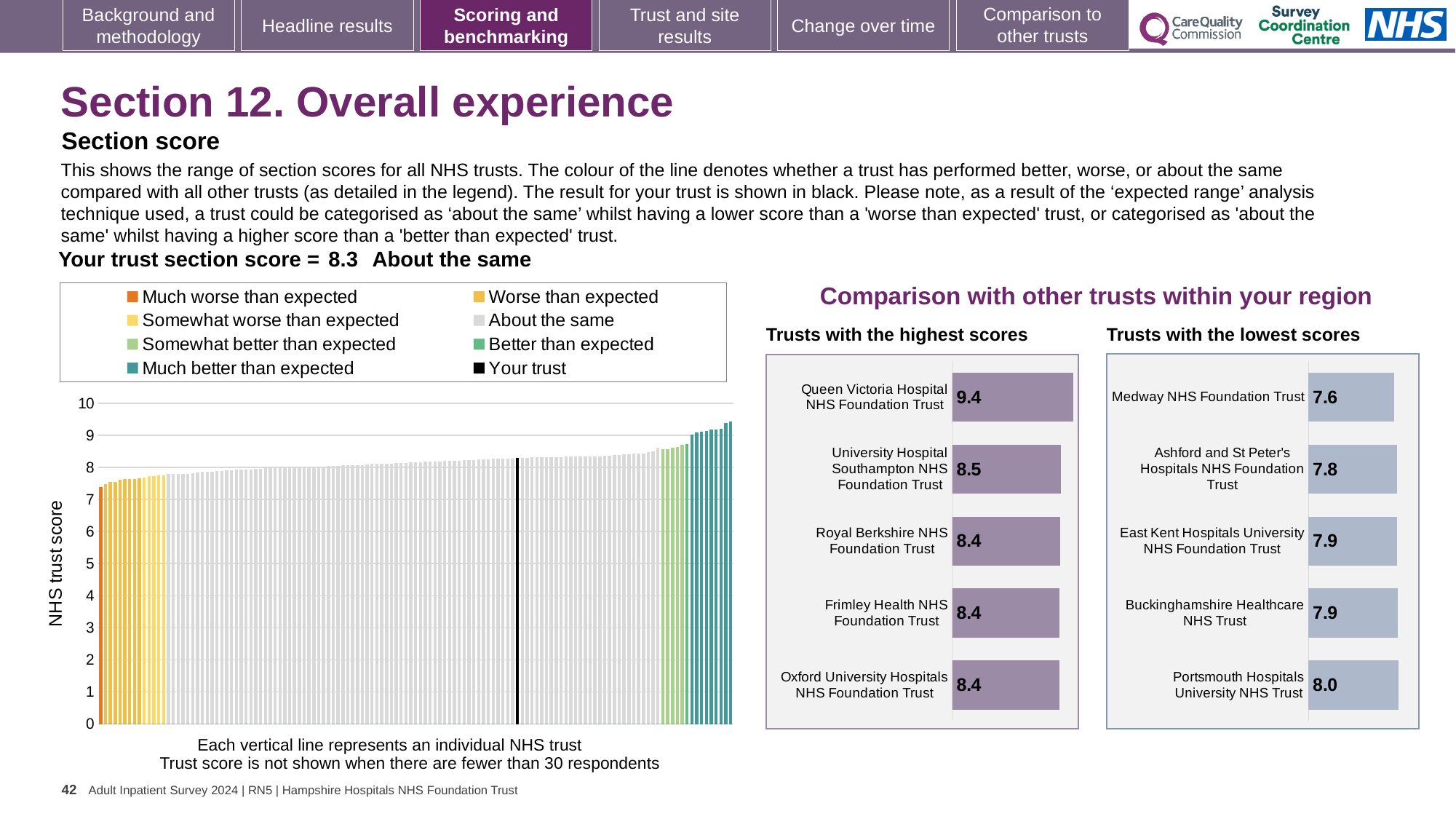
In the 'Trusts with the highest scores' chart, what is the score for Queen Victoria Hospital NHS Foundation Trust? 9.4 What is the section score for your trust shown above the large chart on the left? 8.3 In the 'Trusts with the lowest scores' chart, which trust has the lowest score? Medway NHS Foundation Trust In the 'Trusts with the lowest scores' chart, what is the difference between the scores of Portsmouth Hospitals University NHS Trust and Medway NHS Foundation Trust? 0.4 In the 'Trusts with the highest scores' chart, which trust has the highest score? Queen Victoria Hospital NHS Foundation Trust What kind of chart is the large 'NHS trust score' chart on the left of the slide? Bar chart How many trusts are shown in the 'Trusts with the highest scores' chart? 5 In the large 'NHS trust score' chart on the left, do the values rise or fall from left to right? Rise In the 'Trusts with the highest scores' chart, which has the higher score: Royal Berkshire NHS Foundation Trust or University Hospital Southampton NHS Foundation Trust? University Hospital Southampton NHS Foundation Trust In the 'Trusts with the lowest scores' chart, what is the score for Medway NHS Foundation Trust? 7.6 How many entries does the legend of the large 'NHS trust score' chart on the left list? 8 In the 'Trusts with the highest scores' chart, what is the difference between the scores of Queen Victoria Hospital NHS Foundation Trust and University Hospital Southampton NHS Foundation Trust? 0.9